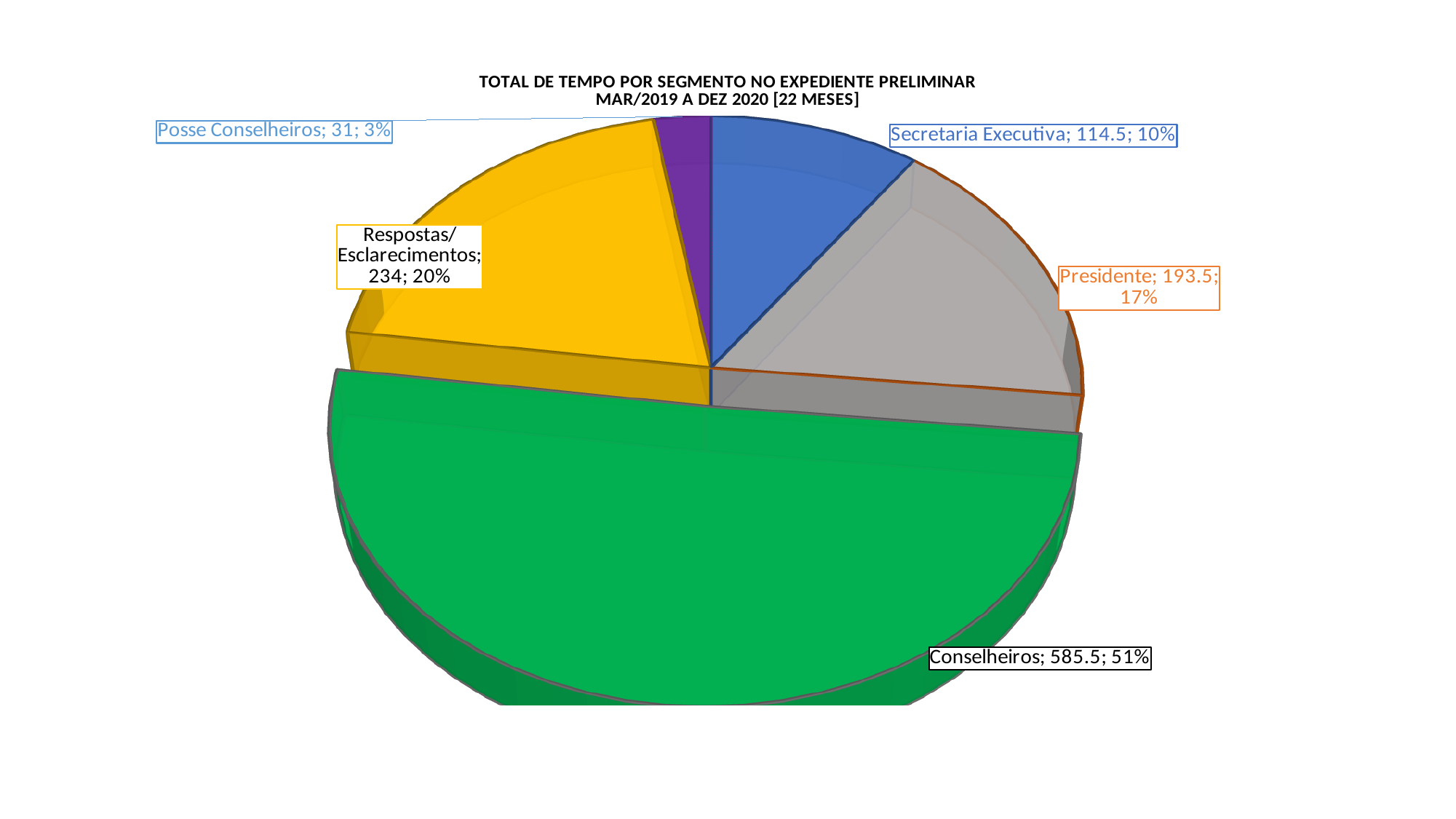
What is the value for Conselheiros? 585.5 What is the value for Presidente? 193.5 What share of the pie does Posse Conselheiros represent? 3% What share of the pie does Respostas/Esclarecimentos represent? 20% Which segment has the smallest slice? Posse Conselheiros How many slices does the pie chart have? 5 Which is larger, the value for Respostas/Esclarecimentos or the value for Presidente? Respostas/Esclarecimentos What is the title of the chart? TOTAL DE TEMPO POR SEGMENTO NO EXPEDIENTE PRELIMINAR MAR/2019 A DEZ 2020 [22 MESES] What is the value for Secretaria Executiva? 114.5 What kind of chart is shown on the slide? pie chart Which segment has the largest slice? Conselheiros What is the difference between the values for Presidente and Secretaria Executiva? 79